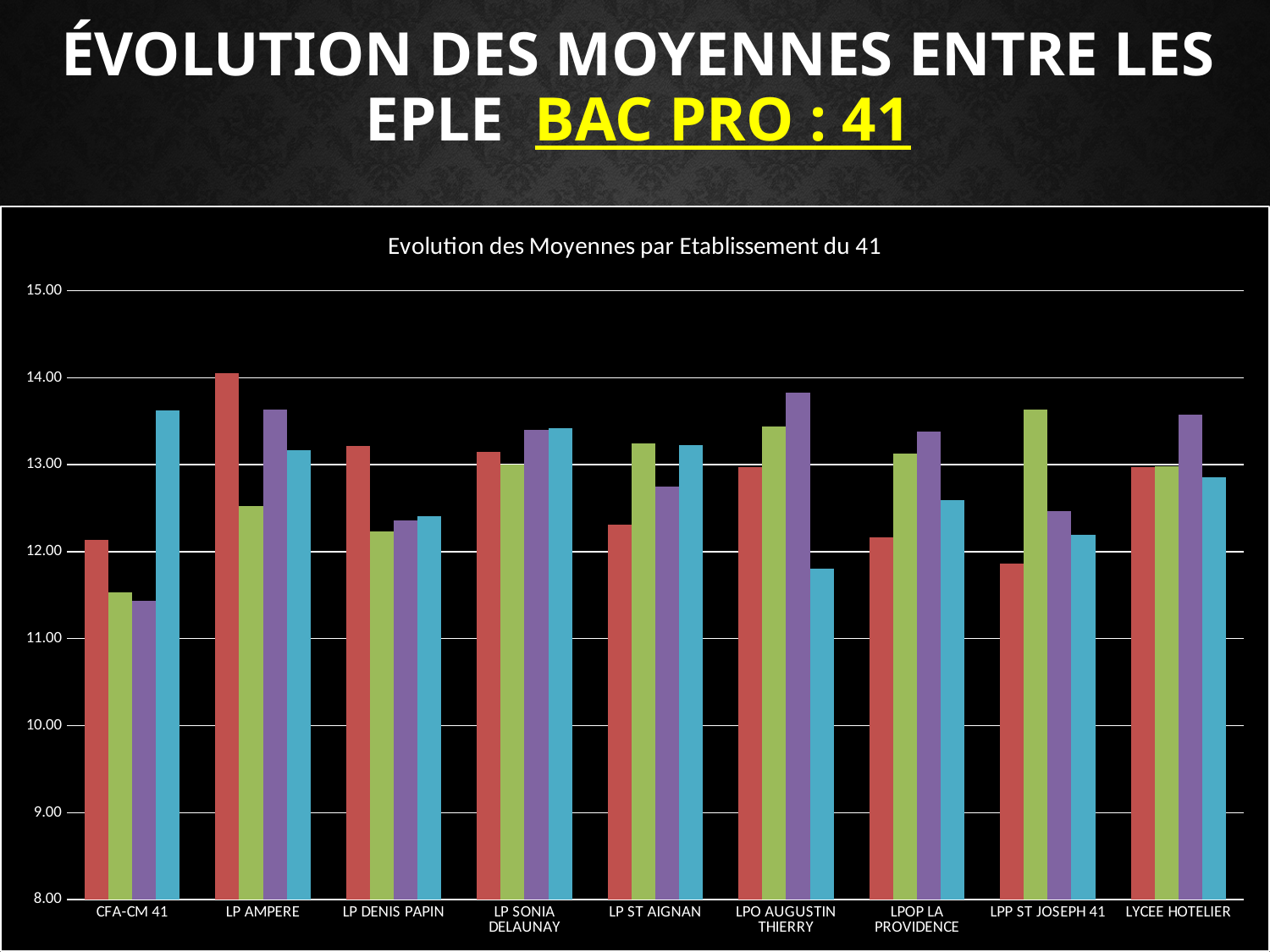
Is the purple bar for LYCEE HOTELIER greater or less than 13.00? greater How many bars are plotted for each establishment in the chart? 4 What is the title of the chart? Evolution des Moyennes par Etablissement du 41 How many establishments (categories) are shown on the x axis of the chart? 9 Is the green bar for CFA-CM 41 greater or less than 12.00? less Which establishment has the highest red bar in the chart? LP AMPERE Is the blue bar for LPO AUGUSTIN THIERRY greater or less than 12.00? less What is the highest value shown on the vertical axis of the chart? 15.00 Which is larger: the red bar for LP AMPERE or the red bar for CFA-CM 41? LP AMPERE What kind of chart is shown on the slide? bar chart Which establishment has the lowest blue bar in the chart? LPO AUGUSTIN THIERRY